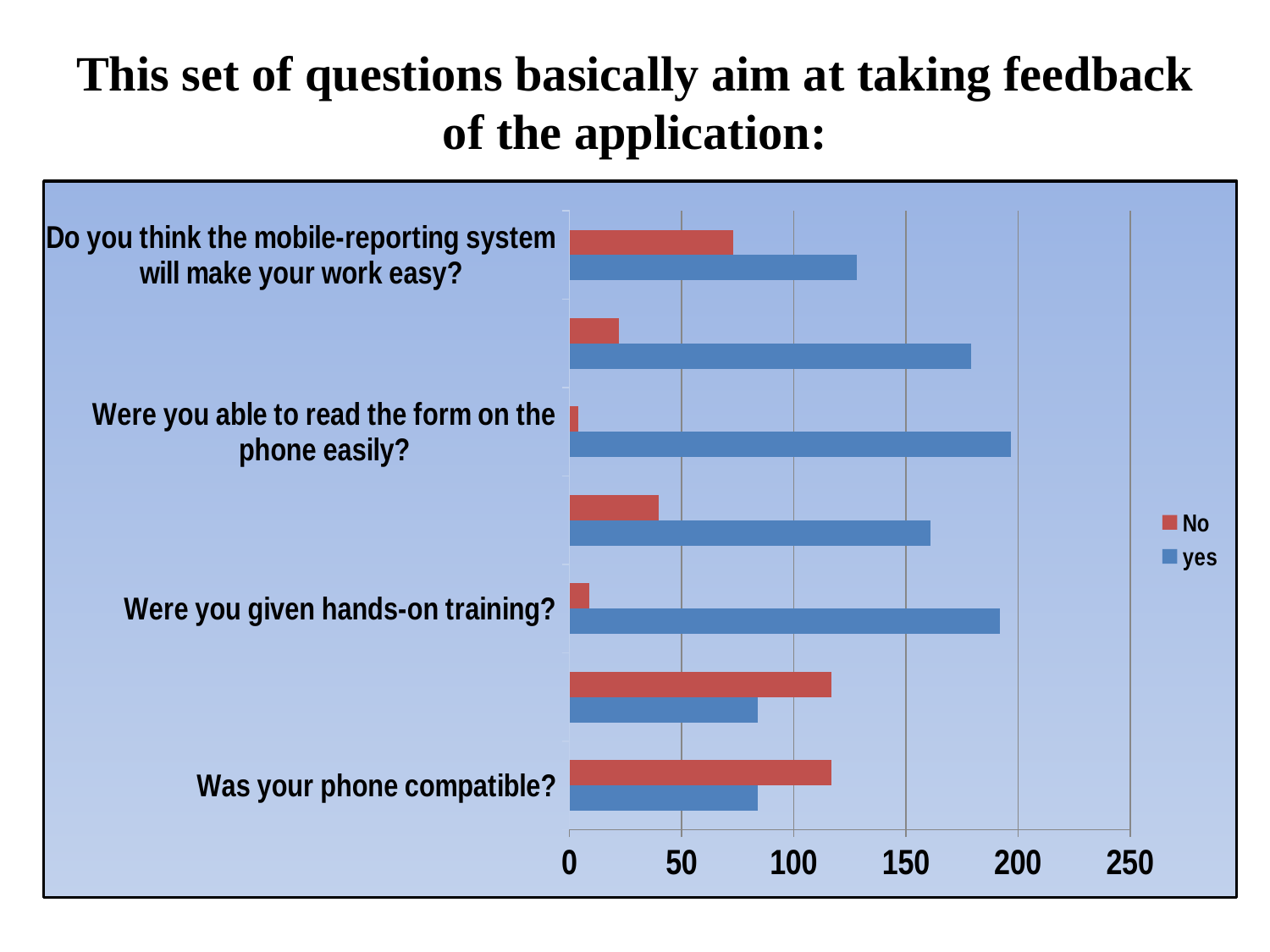
Among the labelled questions, which has the highest "No" value? Was your phone compatible? For "Were you given hands-on training?", which is larger, the "yes" value or the "No" value? yes Is the "yes" value for "Do you think the mobile-reporting system will make your work easy?" greater or less than 100? greater Which colour represents the "No" series? red Is the "No" value for "Do you think the mobile-reporting system will make your work easy?" greater or less than 50? greater Is the "No" value for "Was your phone compatible?" greater or less than 100? greater For "Was your phone compatible?", which is larger, the "No" value or the "yes" value? No What type of chart is shown on the slide? bar chart How many series does the legend list? 2 What are the two series named in the legend? No and yes